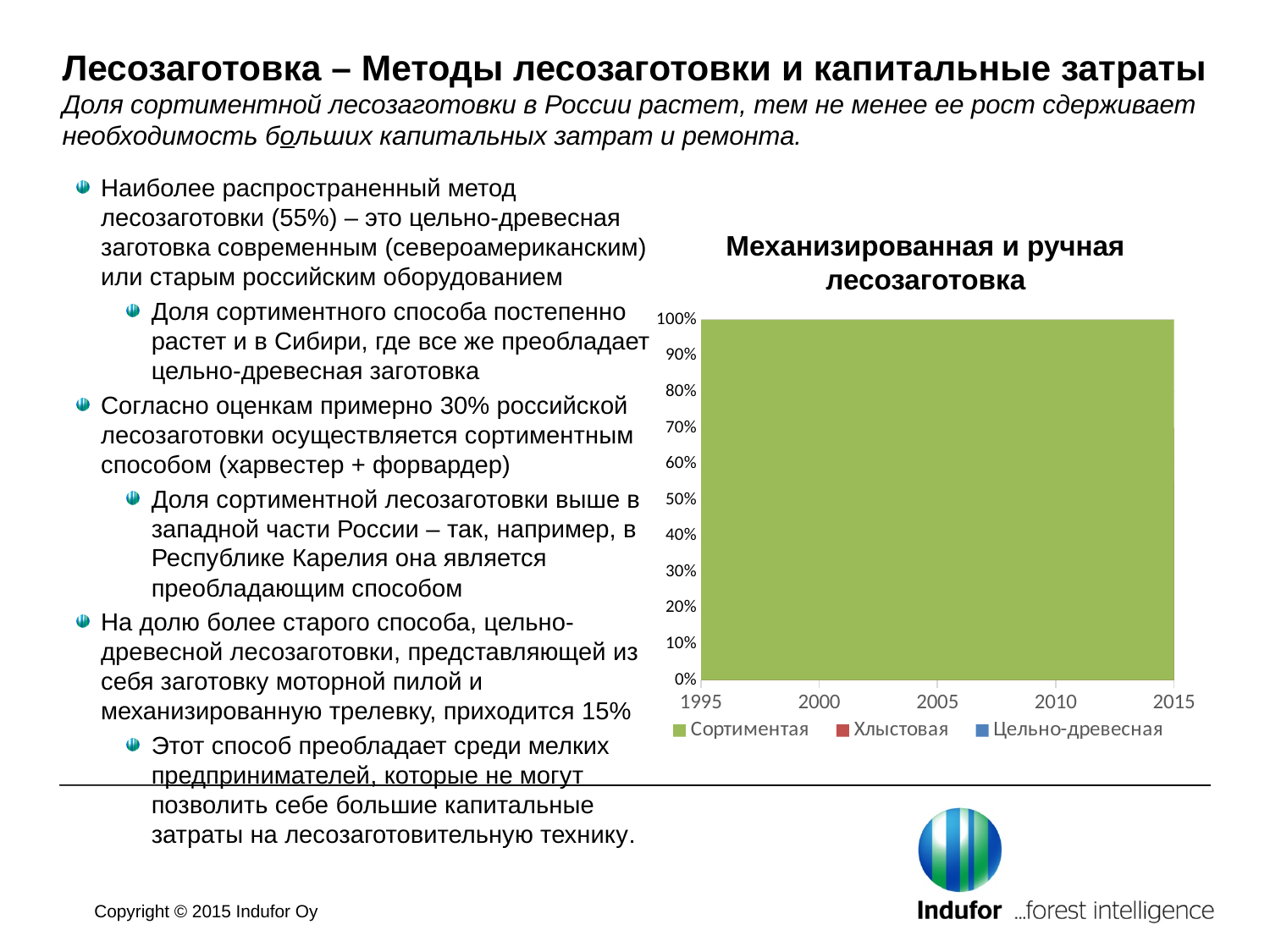
Is the value for Сортиментная in 2010 greater or less than 90%? greater What kind of chart is shown on the slide? area chart What is the highest value shown on the chart's y axis? 100% Is the value for Сортиментная in 2005 greater or less than 50%? greater How many series does the chart's legend list? 3 Which series are listed in the chart's legend? Сортиментая, Хлыстовая, Цельно-древесная How many year labels are shown on the chart's x axis? 5 What is the title of the chart on the slide? Механизированная и ручная лесозаготовка What is the last year shown on the chart's x axis? 2015 What is the first year shown on the chart's x axis? 1995